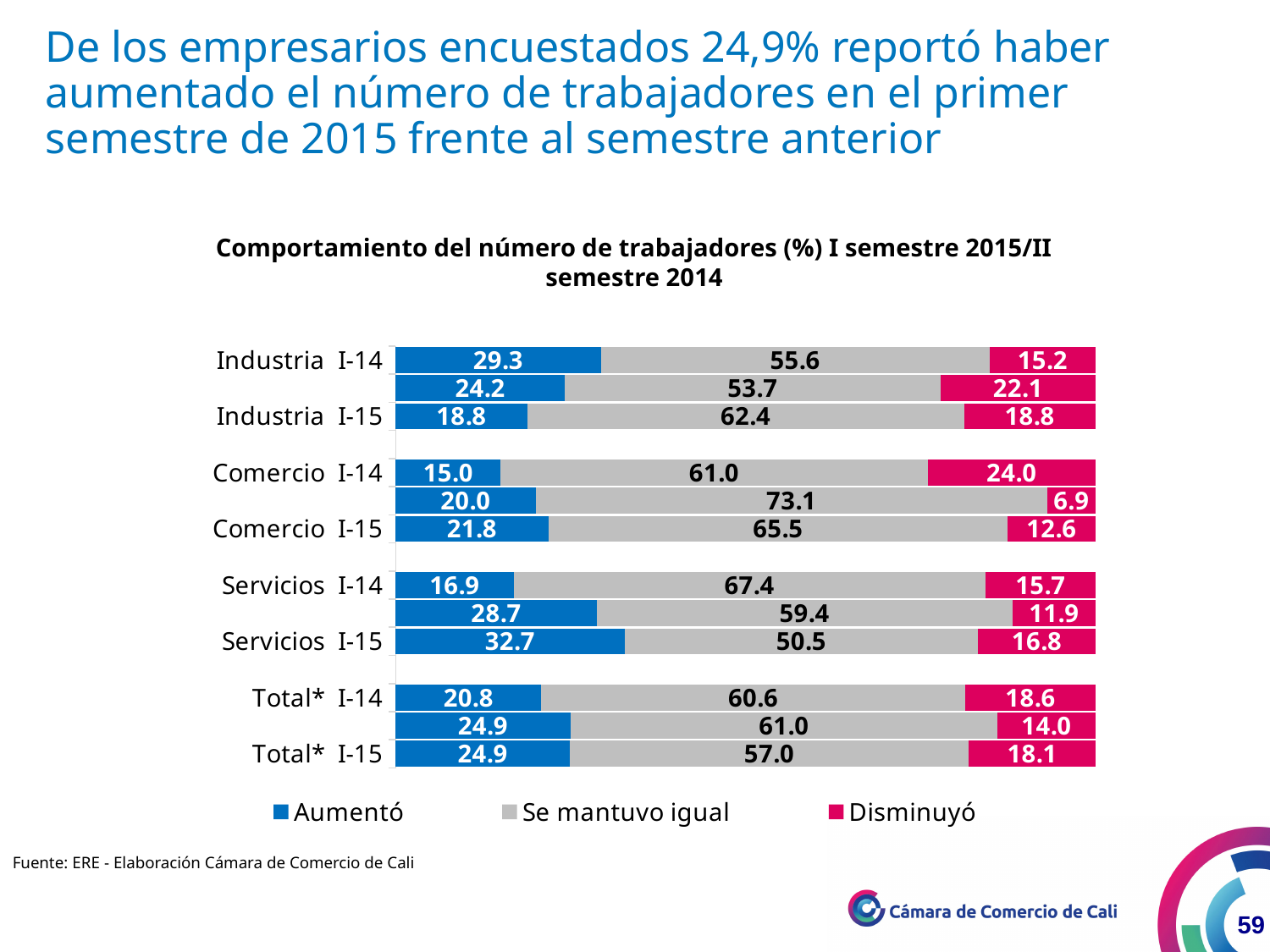
Which labeled bar has the highest 'Disminuyó' value? Comercio I-14 Which labeled bar has the highest 'Aumentó' value? Servicios I-15 What is the 'Se mantuvo igual' value for Comercio I-15? 65.5 What is the 'Disminuyó' value for Total* I-15? 18.1 What is the total of the three segments in the Industria I-14 bar? 100.1 What is the difference between the 'Aumentó' values for Servicios I-15 and Servicios I-14? 15.8 What kind of chart is shown on the slide? Stacked bar chart How many series does the legend list? 3 Which labeled bar has the lowest 'Aumentó' value? Comercio I-14 What percentage of Industria I-14 respondents reported 'Aumentó'? 29.3 What colour represents 'Disminuyó' in the chart? Pink (magenta) Which is larger: the 'Aumentó' value for Industria I-14 or for Total* I-15? Industria I-14